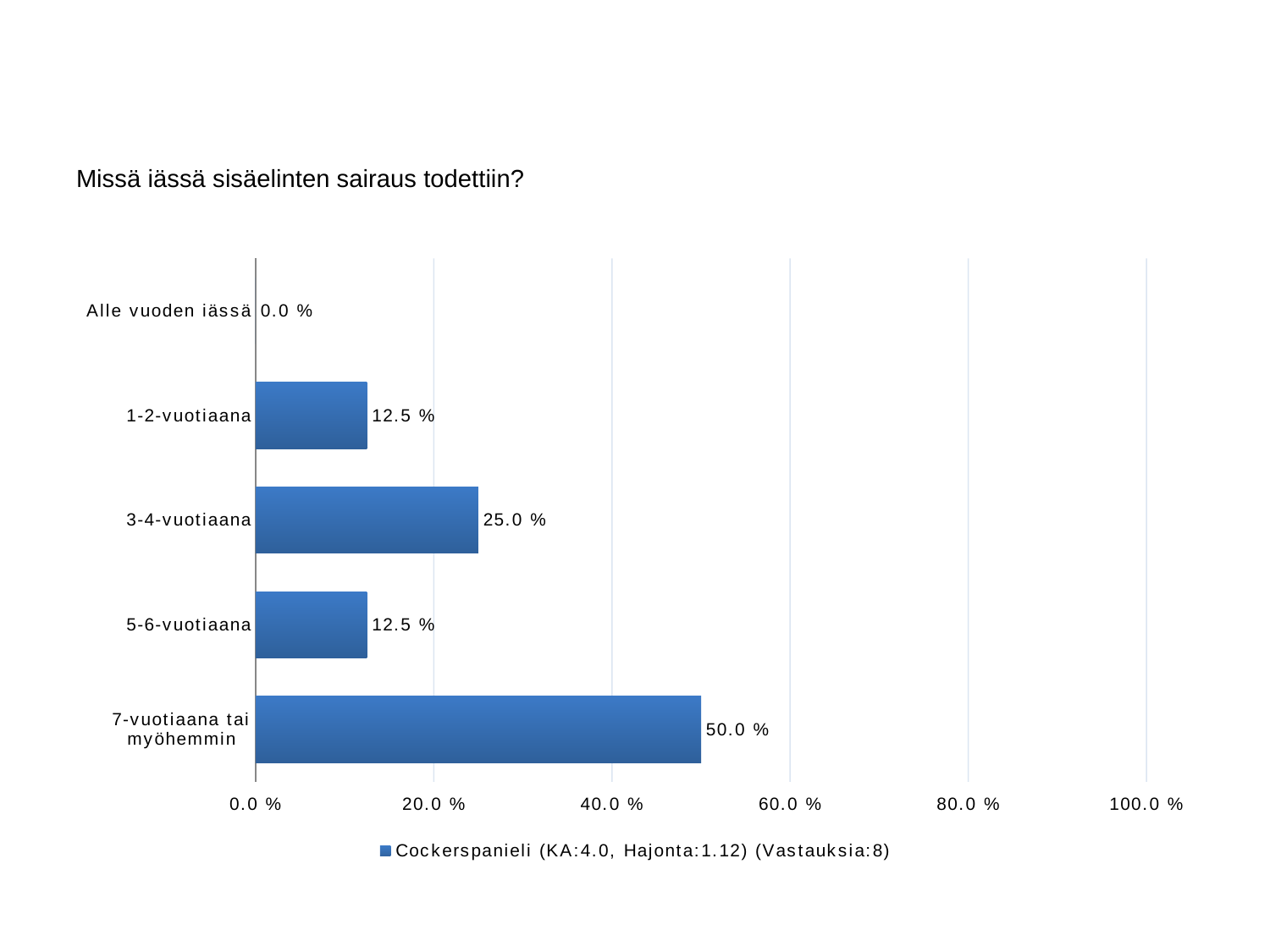
How many categories are shown on the chart? 5 What is the difference between the values for "7-vuotiaana tai myöhemmin" and "3-4-vuotiaana"? 25.0 % What is the value for "Alle vuoden iässä"? 0.0 % What is the title of the chart? Missä iässä sisäelinten sairaus todettiin? Which is larger, the value for "3-4-vuotiaana" or the value for "5-6-vuotiaana"? 3-4-vuotiaana Is the value for "7-vuotiaana tai myöhemmin" greater or less than 40.0 %? greater What is the value for "1-2-vuotiaana"? 12.5 % Which category has the highest value? 7-vuotiaana tai myöhemmin What is the value for "3-4-vuotiaana"? 25.0 % What is the value for "7-vuotiaana tai myöhemmin"? 50.0 % Which category has the lowest value? Alle vuoden iässä What kind of chart is shown on the slide? bar chart